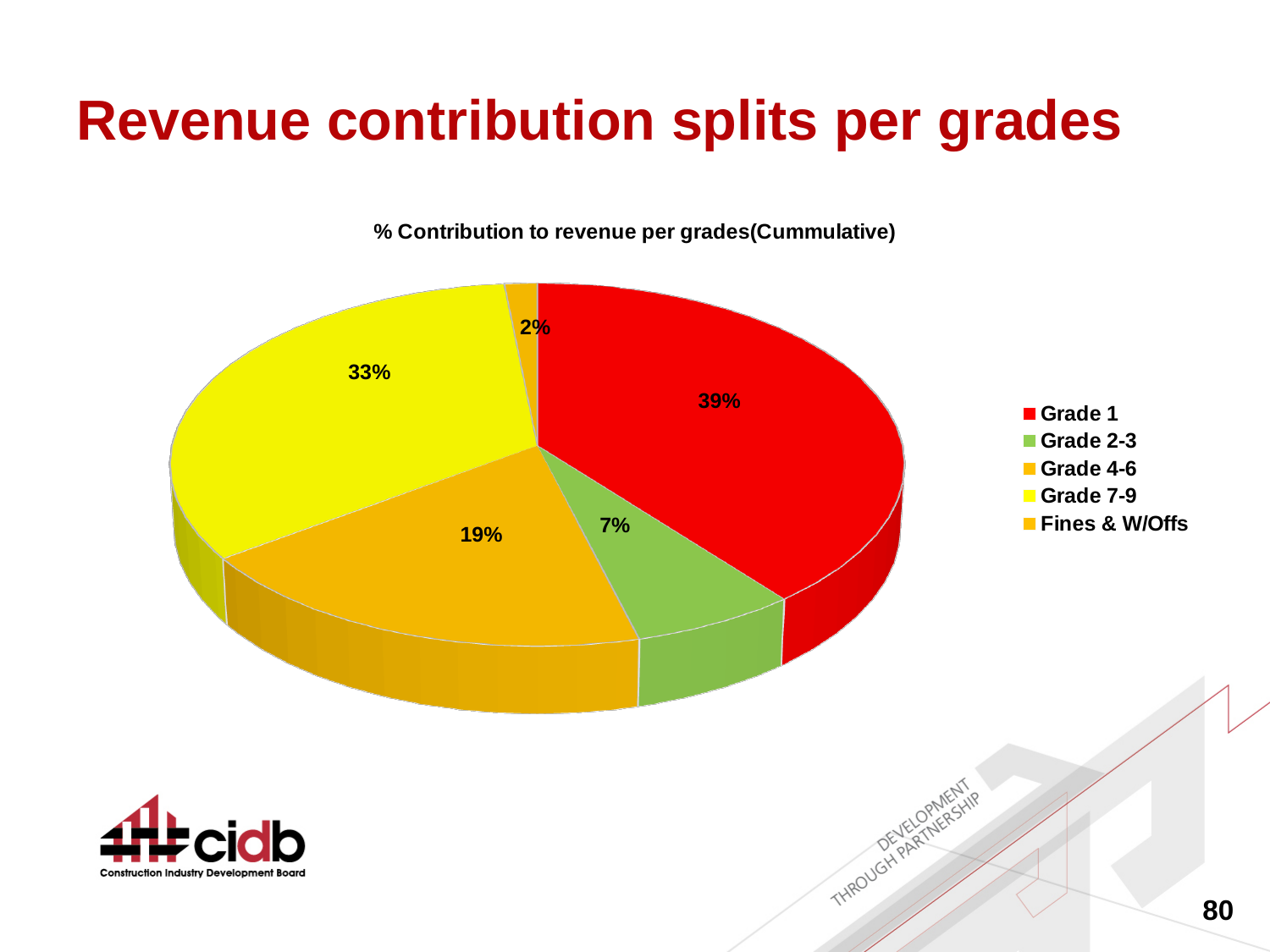
How many categories does the pie chart show? 5 How many percentage points larger is the Grade 1 share than the Grade 7-9 share? 6 What share of revenue does Grade 1 contribute? 39% What share of revenue comes from Fines & W/Offs? 2% What share of revenue does Grade 2-3 contribute? 7% Which category contributes the smallest share of revenue? Fines & W/Offs What kind of chart is shown on the slide? pie chart What is the title of the pie chart? % Contribution to revenue per grades(Cummulative) Which category contributes the largest share of revenue? Grade 1 Which contributes a larger share of revenue, Grade 4-6 or Grade 2-3? Grade 4-6